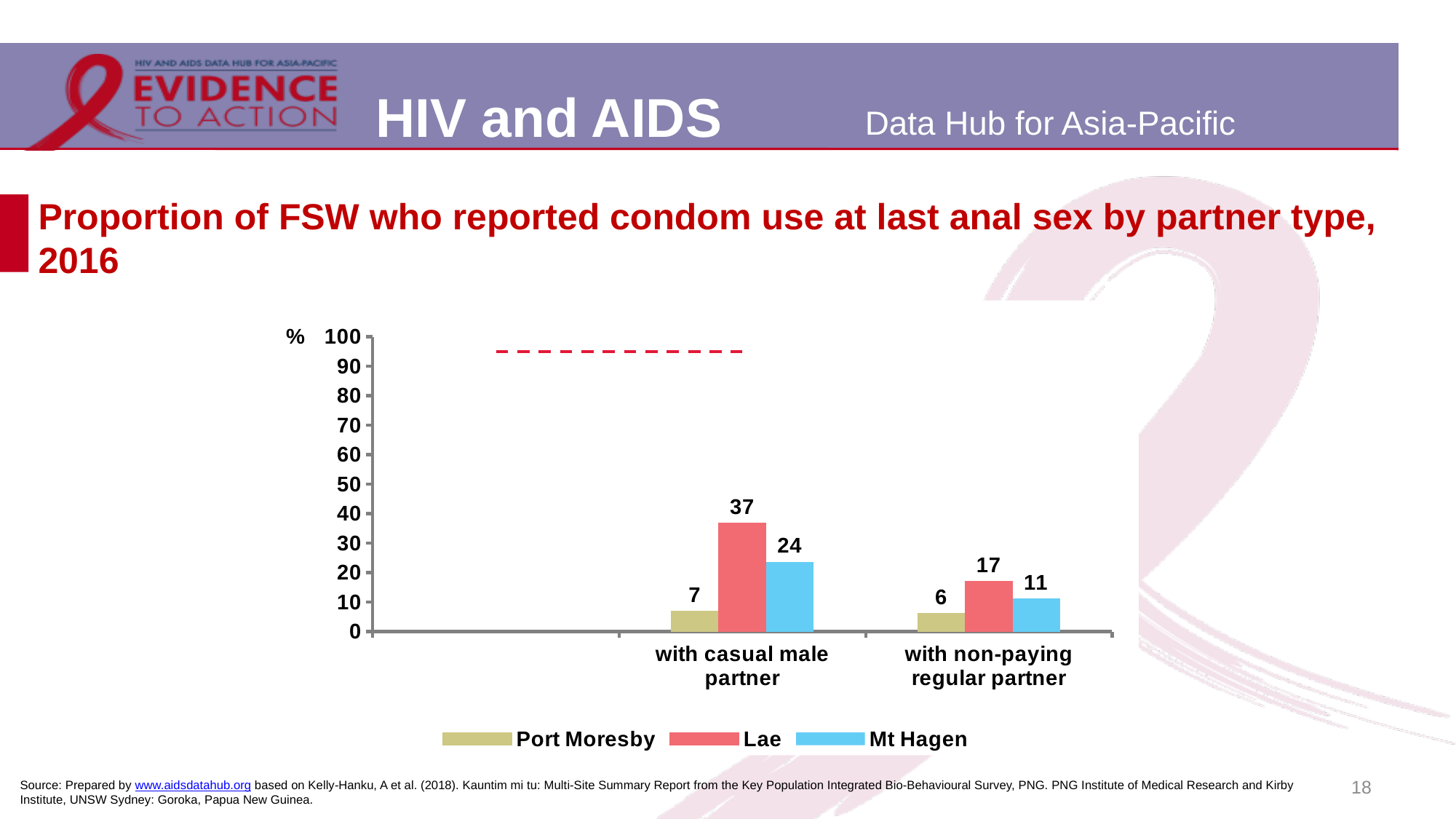
Which is larger: Mt Hagen with casual male partner or Mt Hagen with non-paying regular partner? Mt Hagen with casual male partner What is the value for Lae with casual male partner? 37 How many partner-type categories are shown on the x axis? 2 What is the value for Mt Hagen with casual male partner? 24 Which site has the lowest value with casual male partner? Port Moresby Which site has the highest value with non-paying regular partner? Lae What is the difference between Lae and Mt Hagen with casual male partner? 13 Which colour represents Lae in the legend? Red Is the value for Lae with casual male partner greater or less than 30? greater How many series does the legend list? 3 What kind of chart is shown on the slide? Bar chart What is the value for Port Moresby with non-paying regular partner? 6